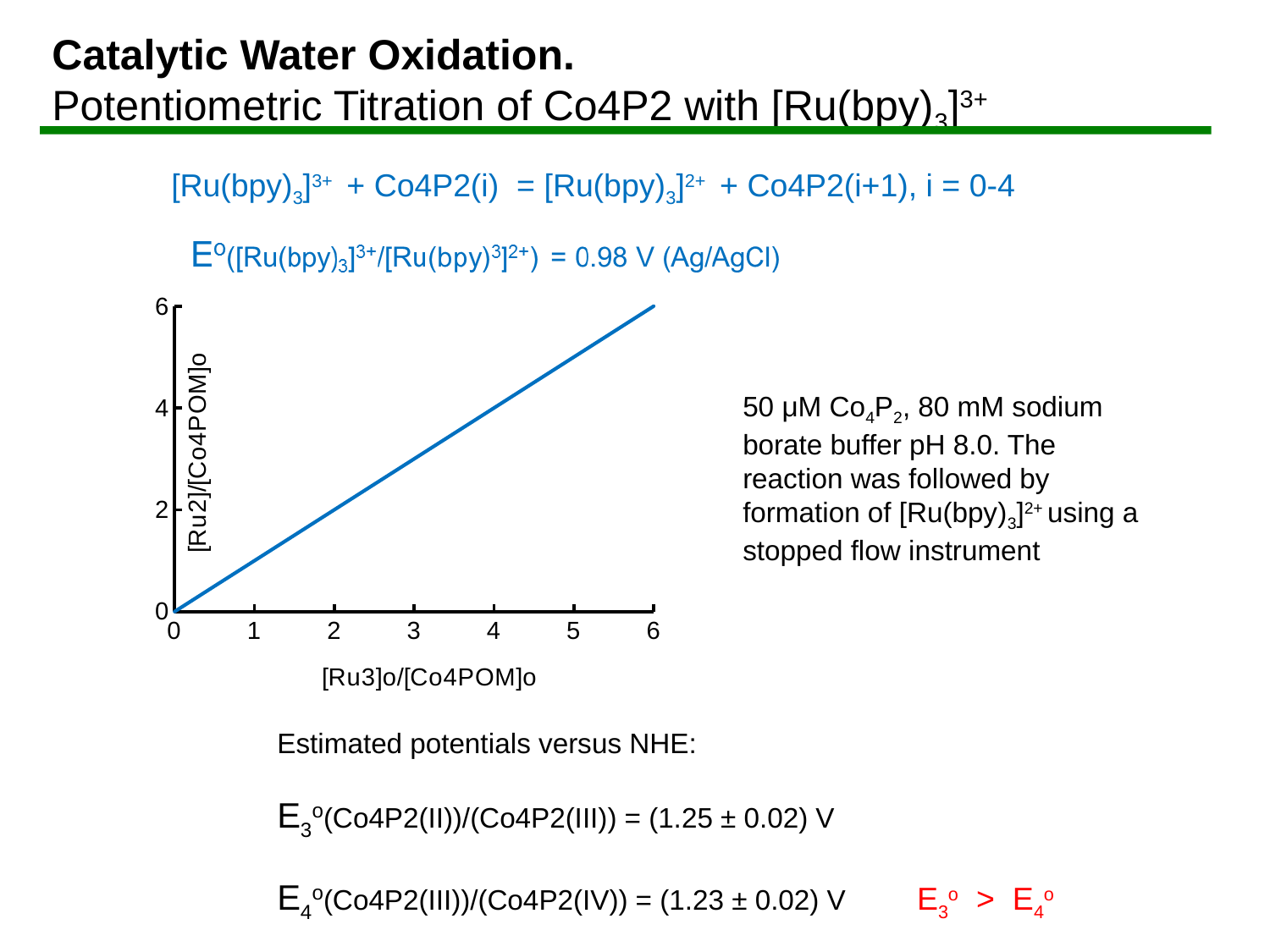
What is the value of [Ru2]/[Co4POM]o where the line starts at [Ru3]o/[Co4POM]o = 0? 0 Is the value of [Ru2]/[Co4POM]o at [Ru3]o/[Co4POM]o = 2 greater or less than 4? less Is the value of [Ru2]/[Co4POM]o at [Ru3]o/[Co4POM]o = 1 greater or less than 2? less What is the value of [Ru2]/[Co4POM]o where the line ends at [Ru3]o/[Co4POM]o = 6? 6 What is the highest value shown on the y axis of the chart? 6 What kind of chart is shown on the slide? line chart Does the plotted line rise or fall as [Ru3]o/[Co4POM]o increases along the x axis? rise Which is larger, the value of [Ru2]/[Co4POM]o at [Ru3]o/[Co4POM]o = 4 or at [Ru3]o/[Co4POM]o = 2? at 4 What is the label of the x axis of the chart? [Ru3]o/[Co4POM]o What is the label of the y axis of the chart? [Ru2]/[Co4POM]o Is the value of [Ru2]/[Co4POM]o at [Ru3]o/[Co4POM]o = 5 greater or less than 4? greater